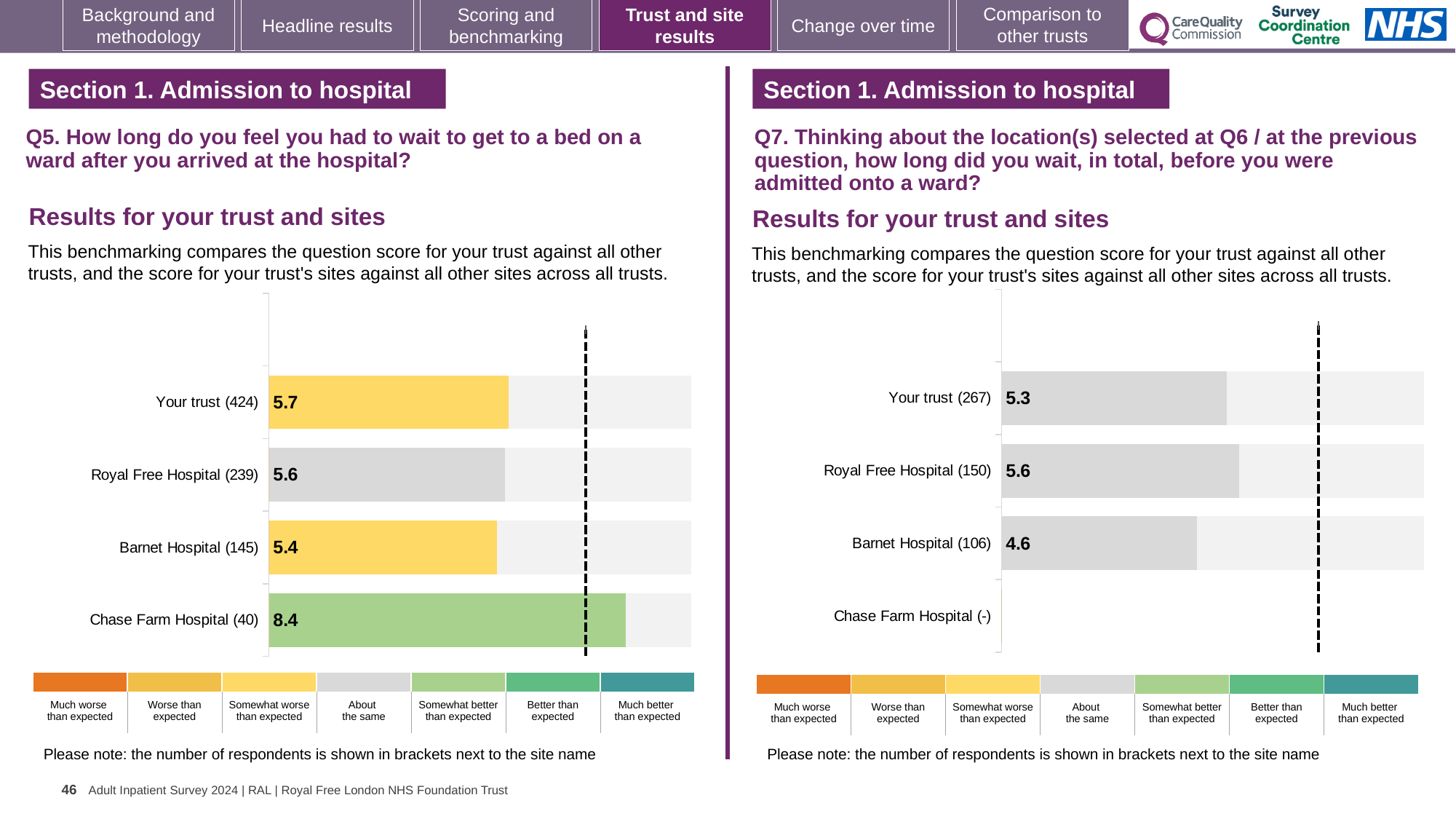
In the Q5 chart on the left, which benchmark category does the colour of the Chase Farm Hospital bar correspond to? Somewhat better than expected In the Q5 chart on the left, what is the score for Chase Farm Hospital? 8.4 In the Q5 chart on the left, what is the score for Your trust? 5.7 In the Q7 chart on the right, which site has the lowest score? Barnet Hospital What type of chart is used for the Q5 results on the left? Bar chart In the Q5 chart on the left, which site has the highest score? Chase Farm Hospital In the Q7 chart on the right, what is the score for Royal Free Hospital? 5.6 In the Q7 chart on the right, what is the difference between the scores for Royal Free Hospital and Your trust? 0.3 In the Q7 chart on the right, what is the score for Barnet Hospital? 4.6 How many respondents are shown in brackets for Your trust in the Q5 chart on the left? 424 In the Q7 chart on the right, which has the higher score, Your trust or Barnet Hospital? Your trust In the Q5 chart on the left, what is the difference between the scores for Chase Farm Hospital and Barnet Hospital? 3.0